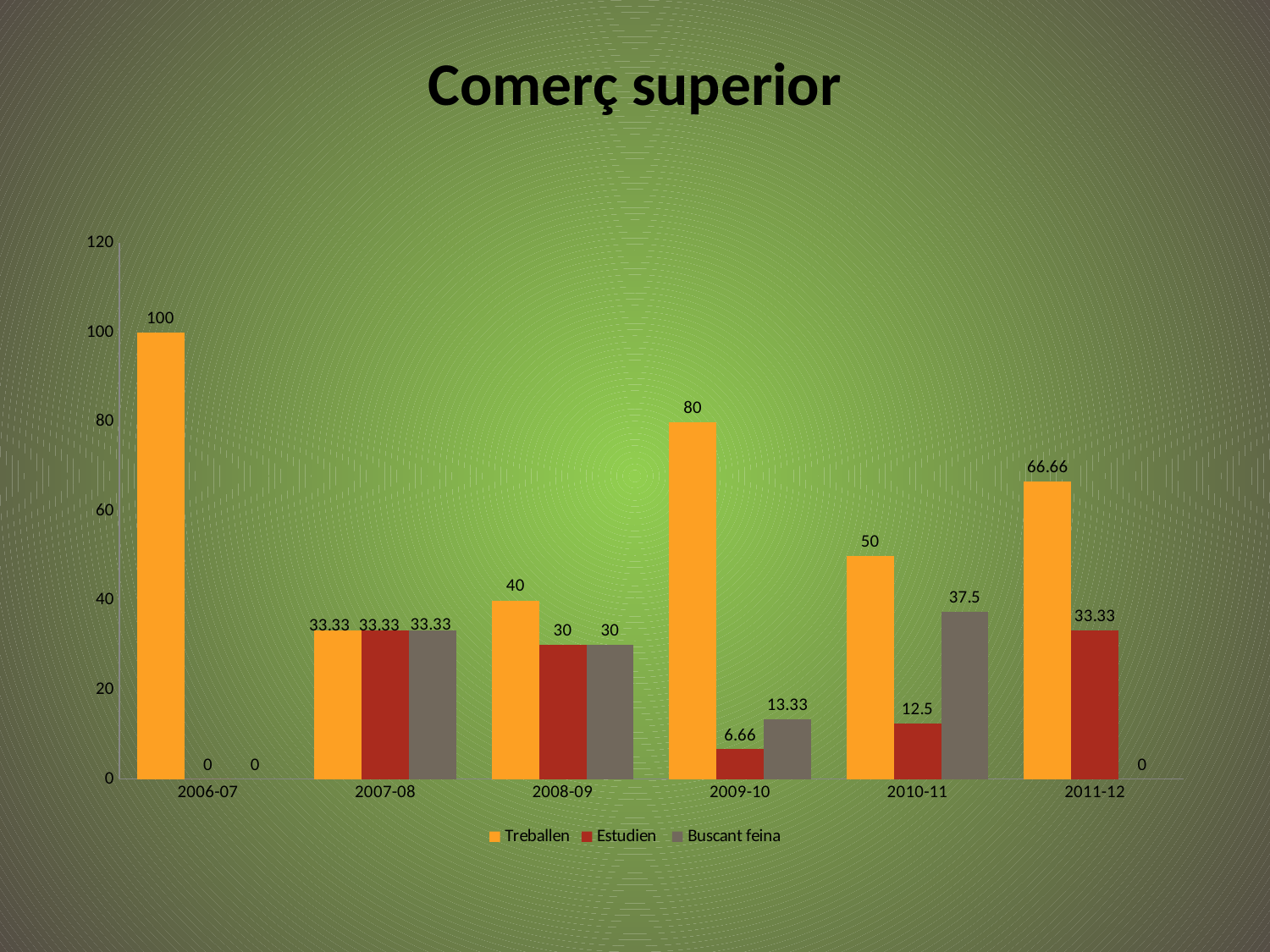
What is the value for Buscant feina in 2010-11? 37.5 In which year is the Treballen value lowest? 2007-08 What is the title of the chart? Comerç superior How many series does the legend list? 3 What is the value for Treballen in 2006-07? 100 What kind of chart is shown on the slide? Bar chart In which year is the Treballen value highest? 2006-07 What is the value for Estudien in 2009-10? 6.66 What is the value for Treballen in 2011-12? 66.66 Which is larger in 2009-10, Estudien or Buscant feina? Buscant feina How many year categories are shown on the x axis? 6 What is the difference between Treballen and Buscant feina in 2010-11? 12.5